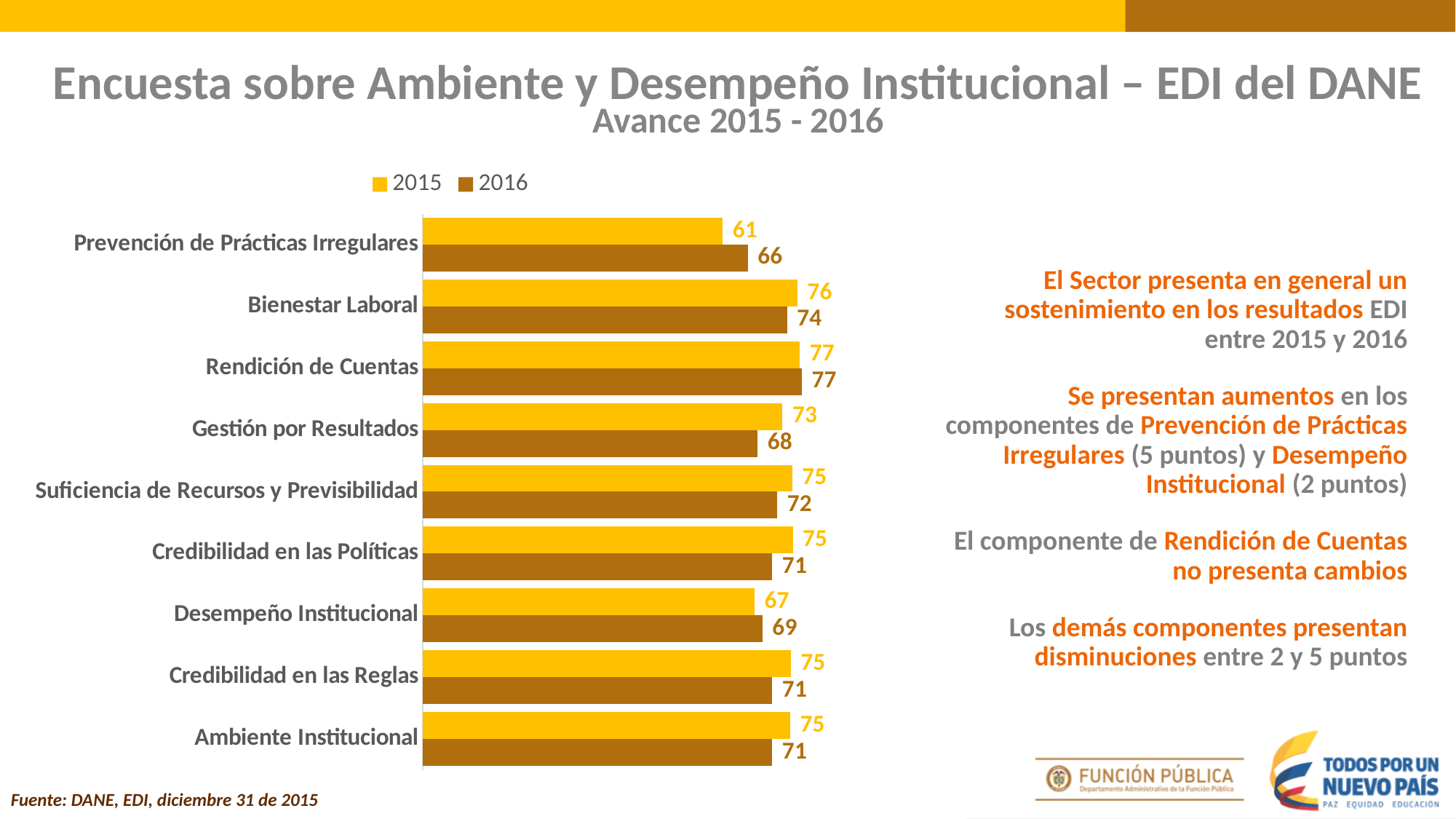
What kind of chart is shown on the slide? Bar chart How many categories are shown on the chart? 9 What is the 2016 value for Gestión por Resultados? 68 What is the 2015 value for Prevención de Prácticas Irregulares? 61 Which category has the lowest 2016 value? Prevención de Prácticas Irregulares What is the 2016 value for Desempeño Institucional? 69 Which category has the highest 2015 value? Rendición de Cuentas How many series does the legend list? 2 What is the difference between the 2015 and 2016 values for Gestión por Resultados? 5 Which category has the lowest 2015 value? Prevención de Prácticas Irregulares Which is larger for Bienestar Laboral, the 2015 value or the 2016 value? 2015 What is the difference between the 2015 and 2016 values for Prevención de Prácticas Irregulares? 5